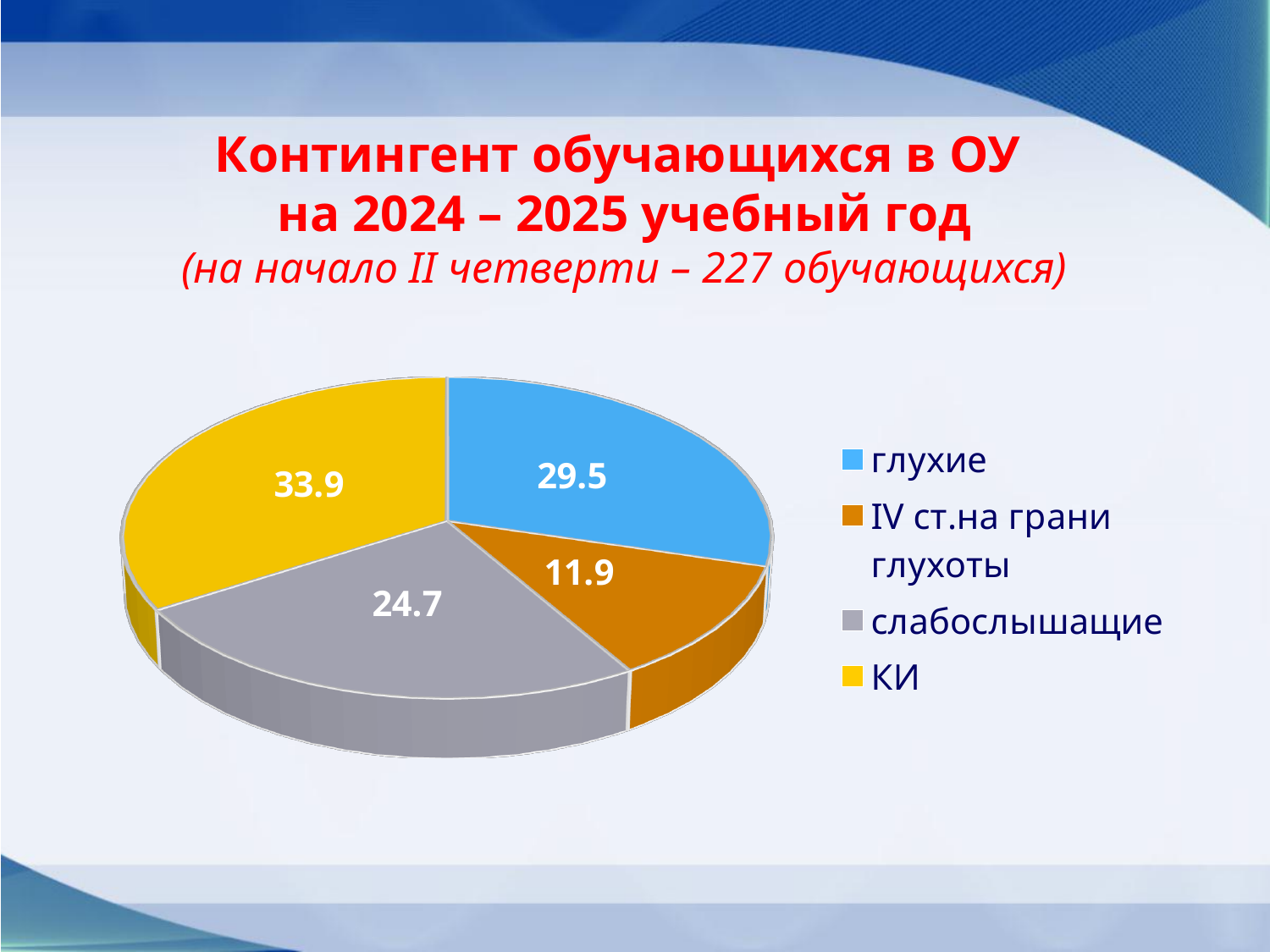
Which category has the smallest slice? IV ст.на грани глухоты What is the difference between the values for КИ and глухие? 4.4 What is the value for слабослышащие? 24.7 What is the value for глухие? 29.5 How many slices does the pie chart have? 4 What kind of chart is shown on the slide? pie chart What is the difference between the values for слабослышащие and IV ст.на грани глухоты? 12.8 What is the value for КИ? 33.9 Which category has the largest slice? КИ What colour is the slice for слабослышащие? grey Which is larger, the value for глухие or the value for слабослышащие? глухие What is the value for IV ст.на грани глухоты? 11.9